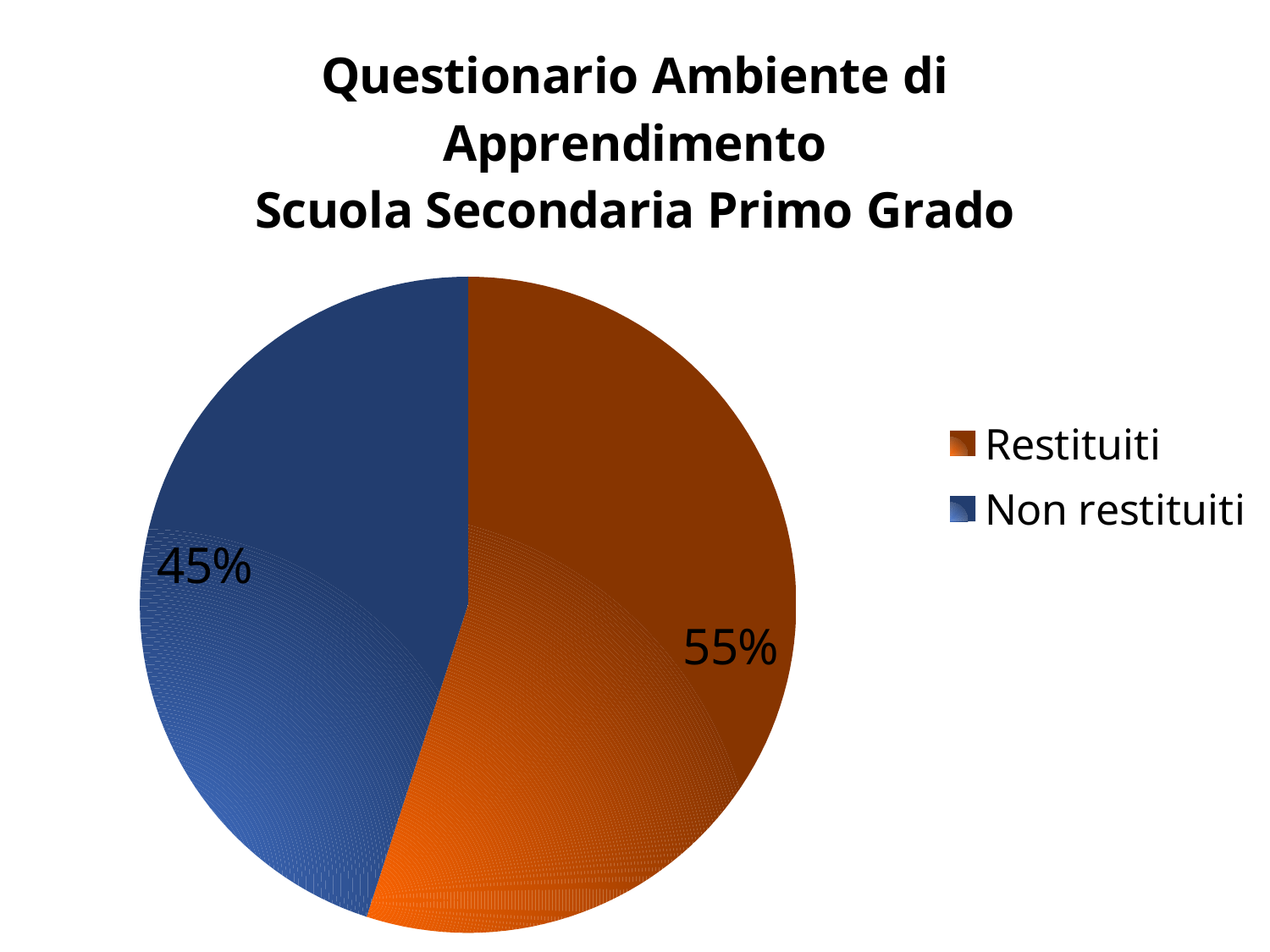
What colour is the Non restituiti slice? blue What is the title of the chart? Questionario Ambiente di Apprendimento Scuola Secondaria Primo Grado What is the difference in percentage points between the Restituiti and Non restituiti slices? 10% What kind of chart is shown on the slide? pie chart Which slice is the smallest? Non restituiti Which slice is the largest? Restituiti How many slices does the pie chart have? 2 What share of the pie is labelled Non restituiti? 45% How many entries does the legend list? 2 Which is larger, the Restituiti slice or the Non restituiti slice? Restituiti What share of the pie is labelled Restituiti? 55%